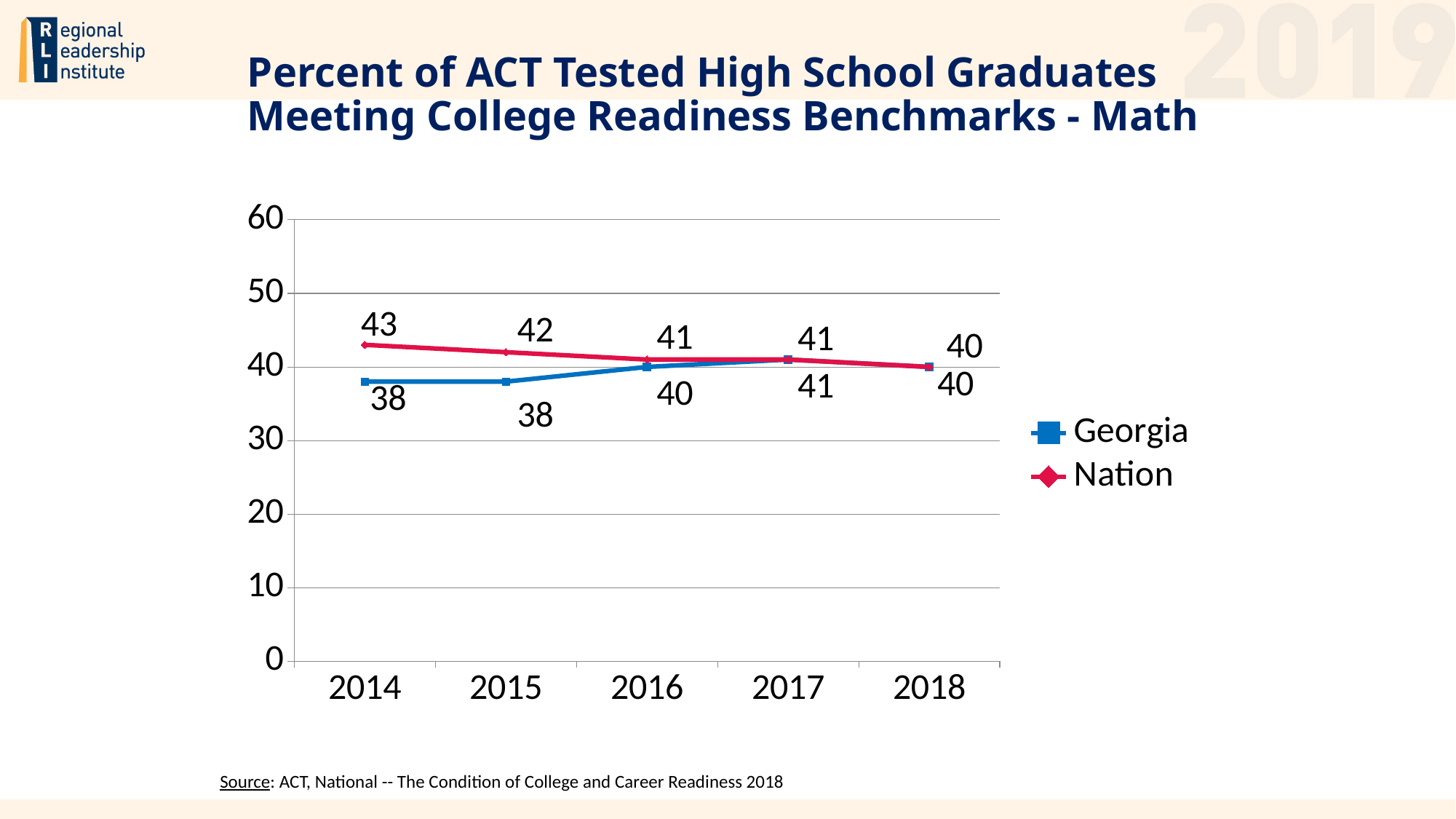
What was the value for Georgia in 2017? 41 In which year was the Nation value highest? 2014 What was the value for Nation in 2018? 40 What is the difference between the Nation and Georgia values in 2014? 5 How many years are plotted on the x axis? 5 Which series is drawn in red? Nation How many series does the legend list? 2 Does the Nation line rise or fall from 2014 to 2018? fall Which was larger in 2015, Georgia or Nation? Nation What kind of chart is shown on the slide? line chart What was the value for Nation in 2014? 43 What was the value for Georgia in 2014? 38